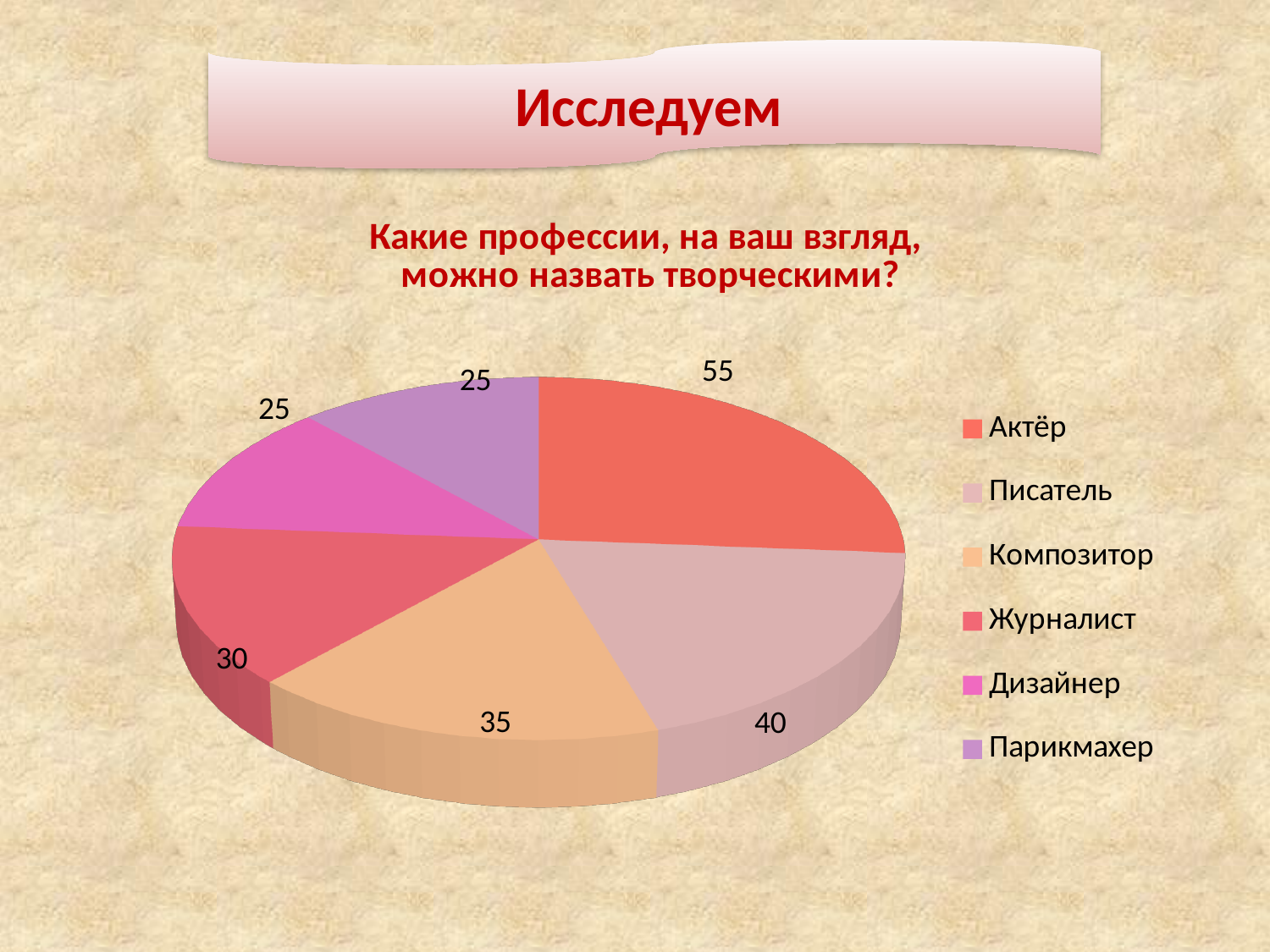
What is the total of all values shown on the pie chart? 210 What type of chart is shown on the slide? Pie chart Which profession has the largest slice of the pie chart? Актёр What is the difference between the values for Актёр and Писатель? 15 What value is shown for Композитор on the pie chart? 35 What value is shown for Журналист on the pie chart? 30 How many categories does the pie chart show? 6 What value is shown for Писатель on the pie chart? 40 What question is the pie chart answering, according to its title? Какие профессии, на ваш взгляд, можно назвать творческими? What value is shown for Актёр on the pie chart? 55 Which is larger, the value for Журналист or the value for Парикмахер? Журналист What is the difference between the values for Композитор and Дизайнер? 10